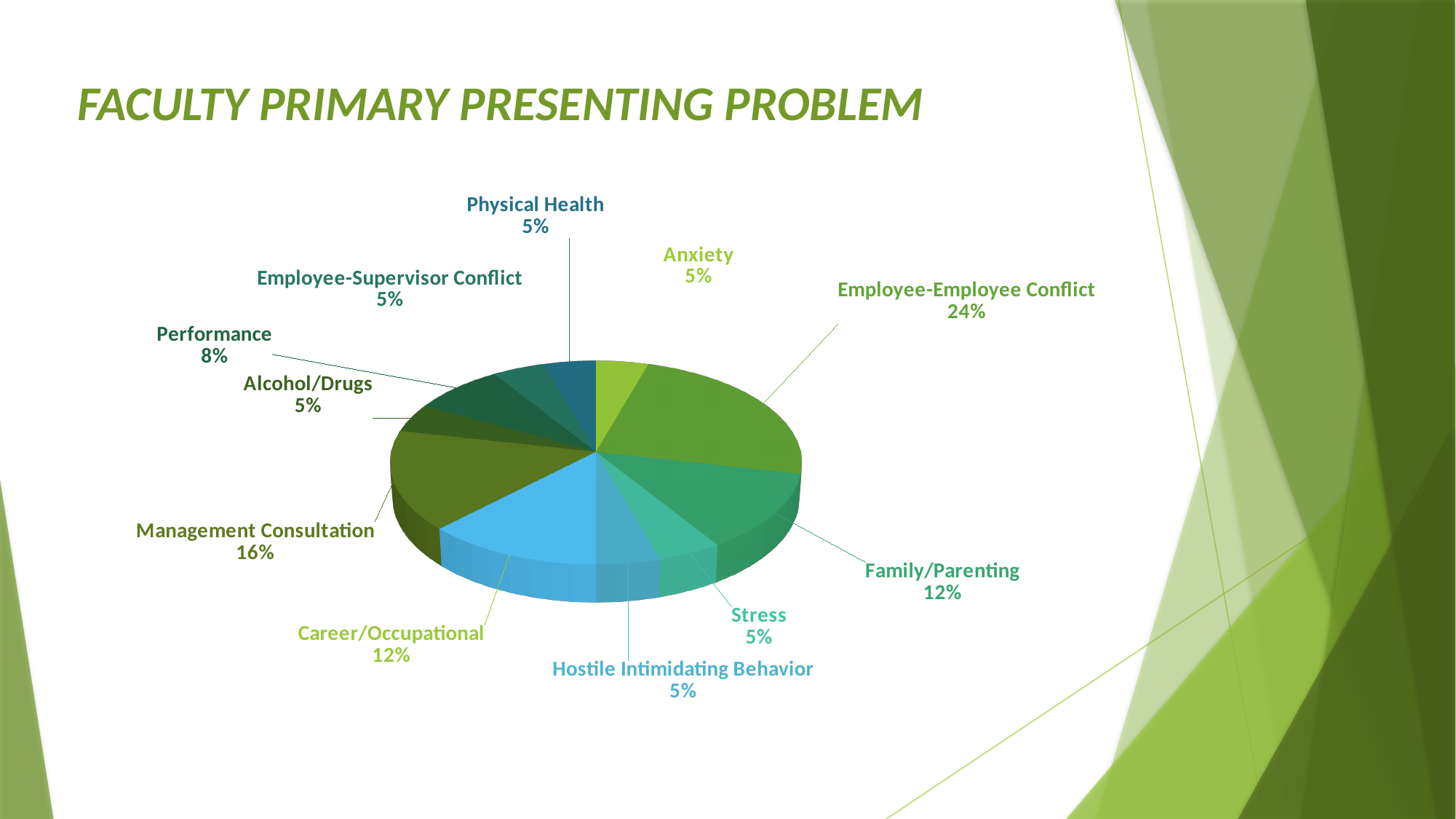
What is the value for Performance? 8% What share of the pie does Family/Parenting represent? 12% What is the difference between the Employee-Employee Conflict share and the Management Consultation share? 8% Which is larger, Career/Occupational or Performance? Career/Occupational What percentage is shown for Management Consultation? 16% What percentage is shown for Hostile Intimidating Behavior? 5% What percentage of the pie is Employee-Employee Conflict? 24% What is the title of the chart on the slide? FACULTY PRIMARY PRESENTING PROBLEM How many categories are shown in the pie chart? 11 Which category has the largest share of the pie? Employee-Employee Conflict What is the difference between the Management Consultation share and the Stress share? 11% What kind of chart is shown on the slide? Pie chart